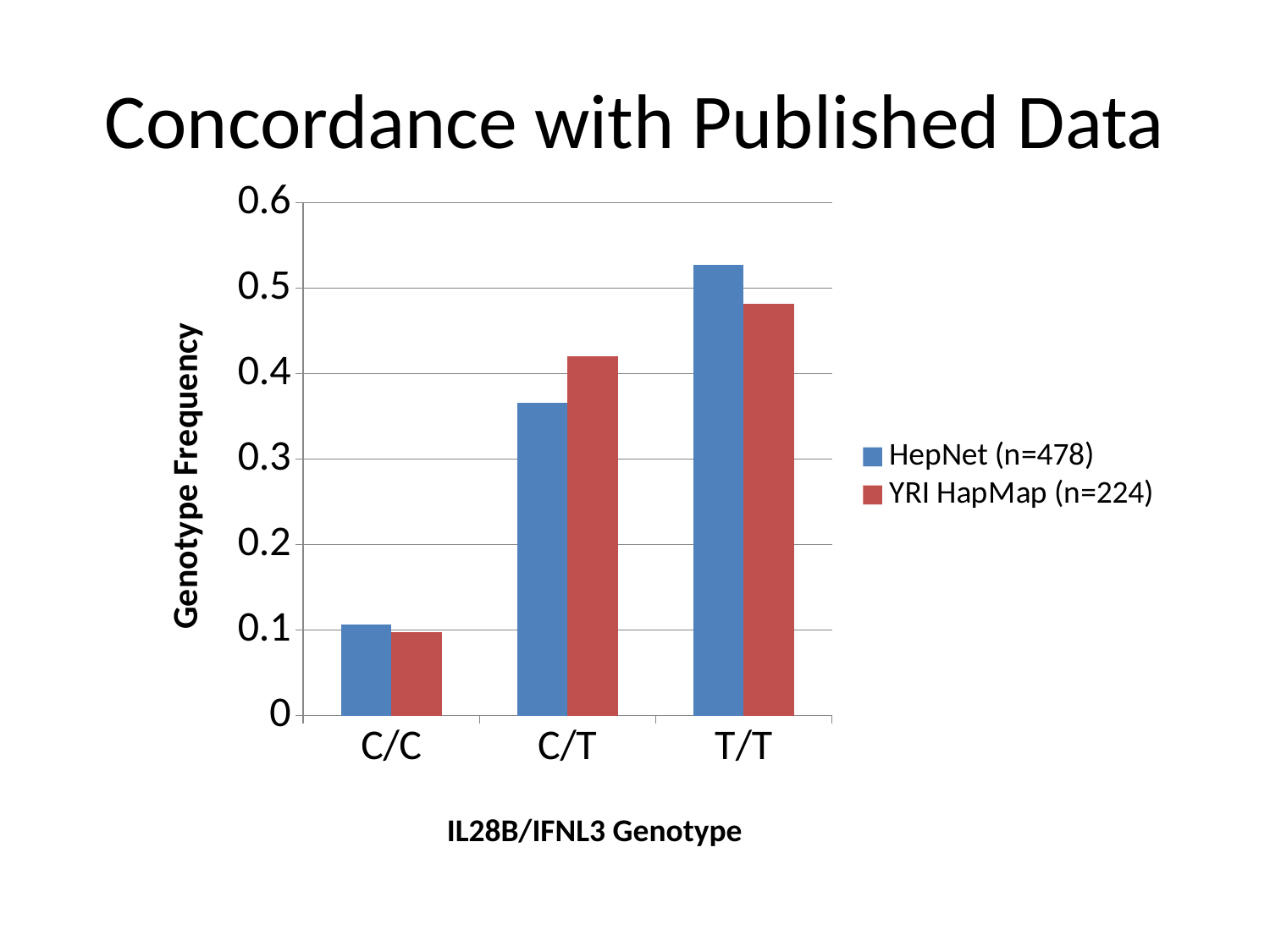
How many genotype categories are shown on the x axis? 3 What is the title of the slide containing the chart? Concordance with Published Data What kind of chart is shown on the slide? bar chart For the T/T genotype, which series has the larger genotype frequency, HepNet (n=478) or YRI HapMap (n=224)? HepNet (n=478) Is the genotype frequency for HepNet (n=478) at T/T greater or less than 0.5? greater Do the HepNet (n=478) genotype frequencies rise or fall from C/C to T/T along the x axis? rise Which genotype has the lowest genotype frequency for YRI HapMap (n=224)? C/C How many series does the legend list? 2 Is the genotype frequency for HepNet (n=478) at C/T greater or less than 0.4? less For the C/T genotype, which series has the larger genotype frequency, HepNet (n=478) or YRI HapMap (n=224)? YRI HapMap (n=224) Which genotype has the highest genotype frequency for HepNet (n=478)? T/T Is the genotype frequency for YRI HapMap (n=224) at T/T greater or less than 0.5? less